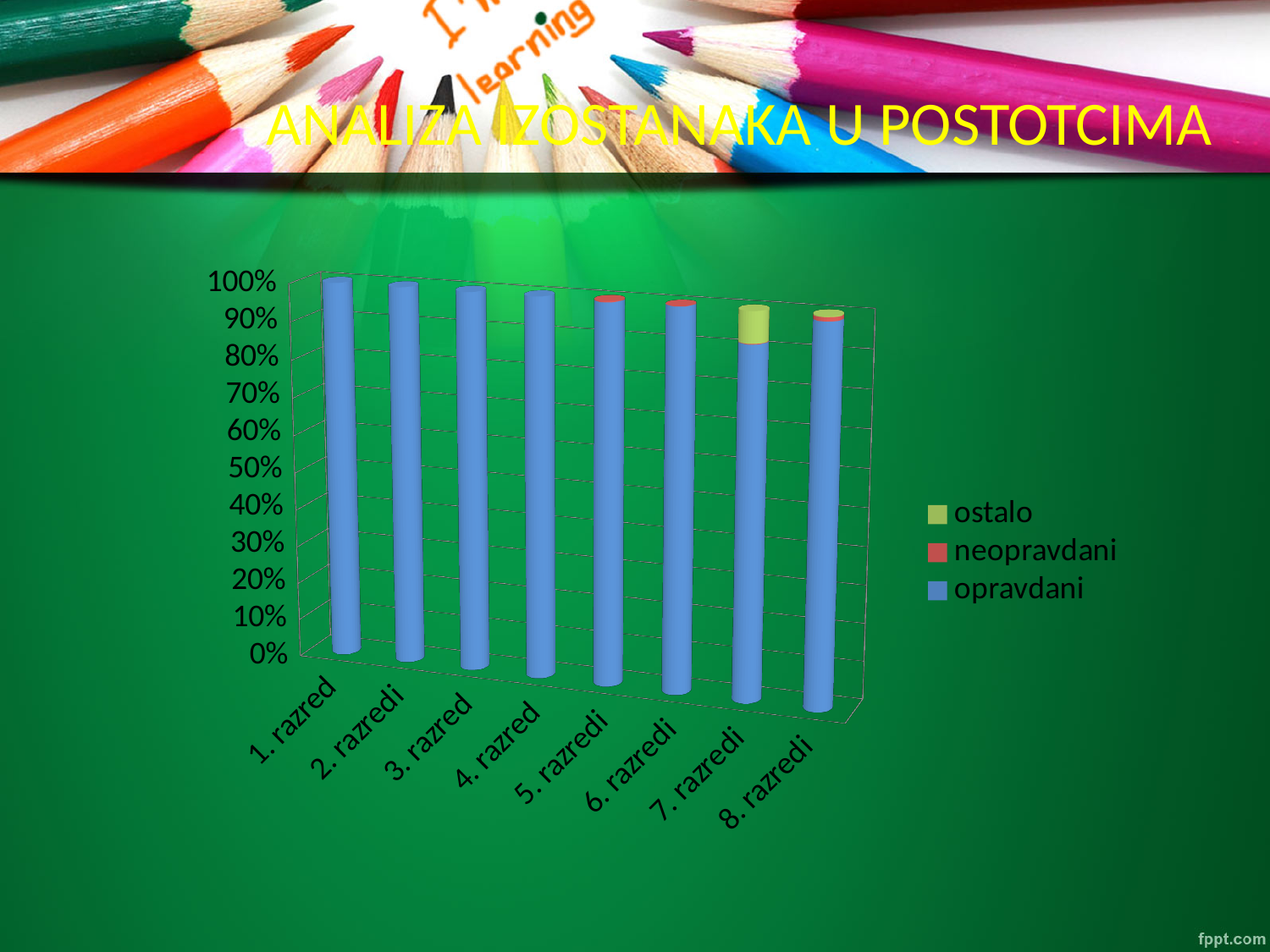
Is the value for opravdani in 1. razred greater or less than 90%? greater How many categories (classes) are shown on the x axis of the chart? 8 What kind of chart is shown on the slide? bar chart Is the value for ostalo in 7. razredi greater or less than 30%? less Which series is shown in blue in the chart? opravdani Is the value for opravdani in 7. razredi greater or less than 50%? greater Which category has the largest share of ostalo? 7. razredi Which category has the smallest share of opravdani? 7. razredi Which is larger, the opravdani share for 1. razred or for 7. razredi? 1. razred What is the title of the slide containing the chart? ANALIZA IZOSTANAKA U POSTOTCIMA How many series does the chart's legend list? 3